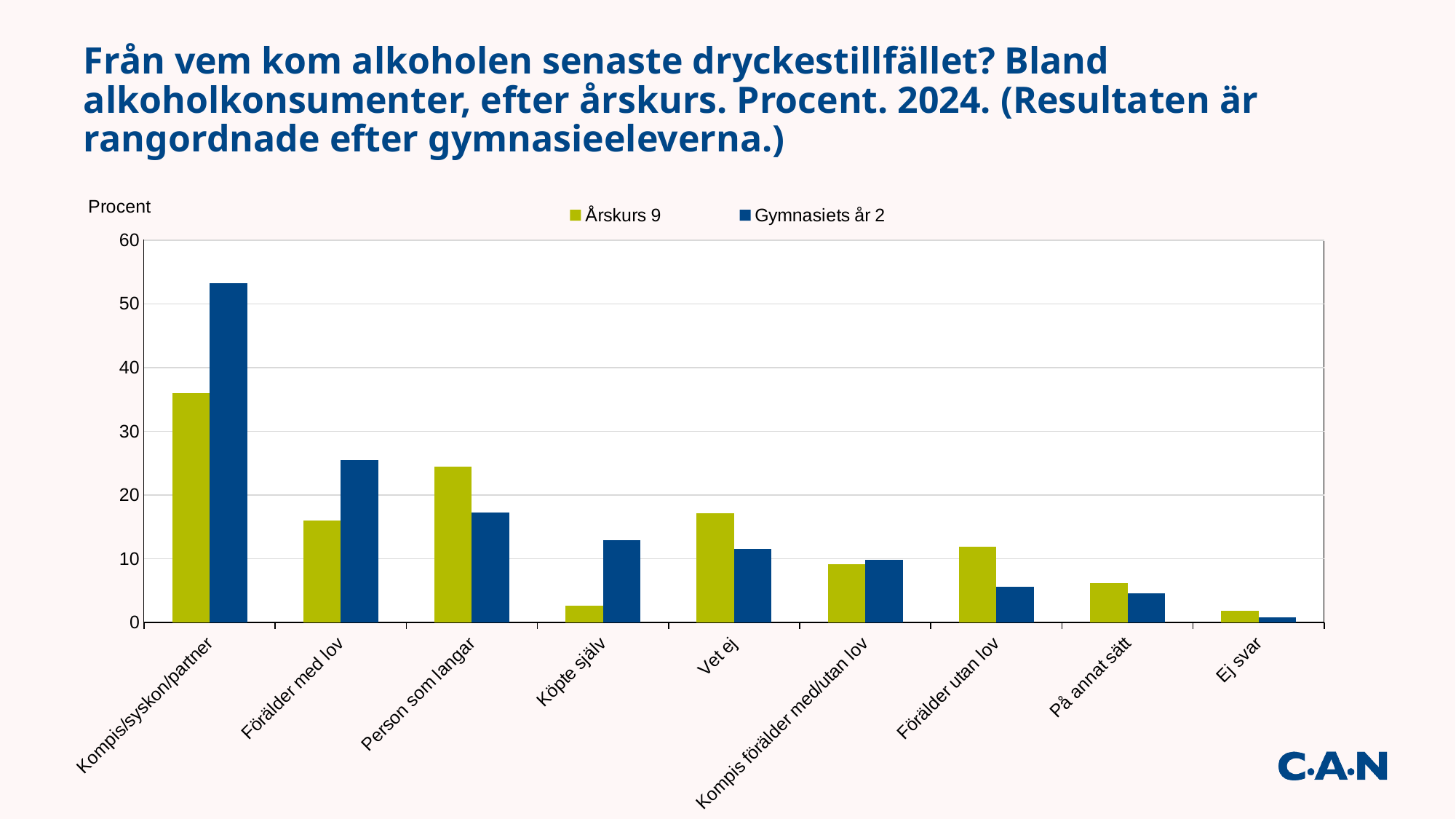
Which category has the highest value for Gymnasiets år 2? Kompis/syskon/partner How many series does the legend list? 2 Which category has the highest value for Årskurs 9? Kompis/syskon/partner Is the Gymnasiets år 2 value for Kompis/syskon/partner greater or less than 50? greater How many categories are shown on the x axis? 9 What label is shown above the y axis? Procent For Person som langar, which series has the larger value, Årskurs 9 or Gymnasiets år 2? Årskurs 9 For Köpte själv, which series has the larger value, Årskurs 9 or Gymnasiets år 2? Gymnasiets år 2 Is the Årskurs 9 value for Köpte själv greater or less than 10? less What kind of chart is shown on the slide? bar chart Which category has the lowest value for Gymnasiets år 2? Ej svar Is the Årskurs 9 value for Förälder med lov greater or less than 20? less